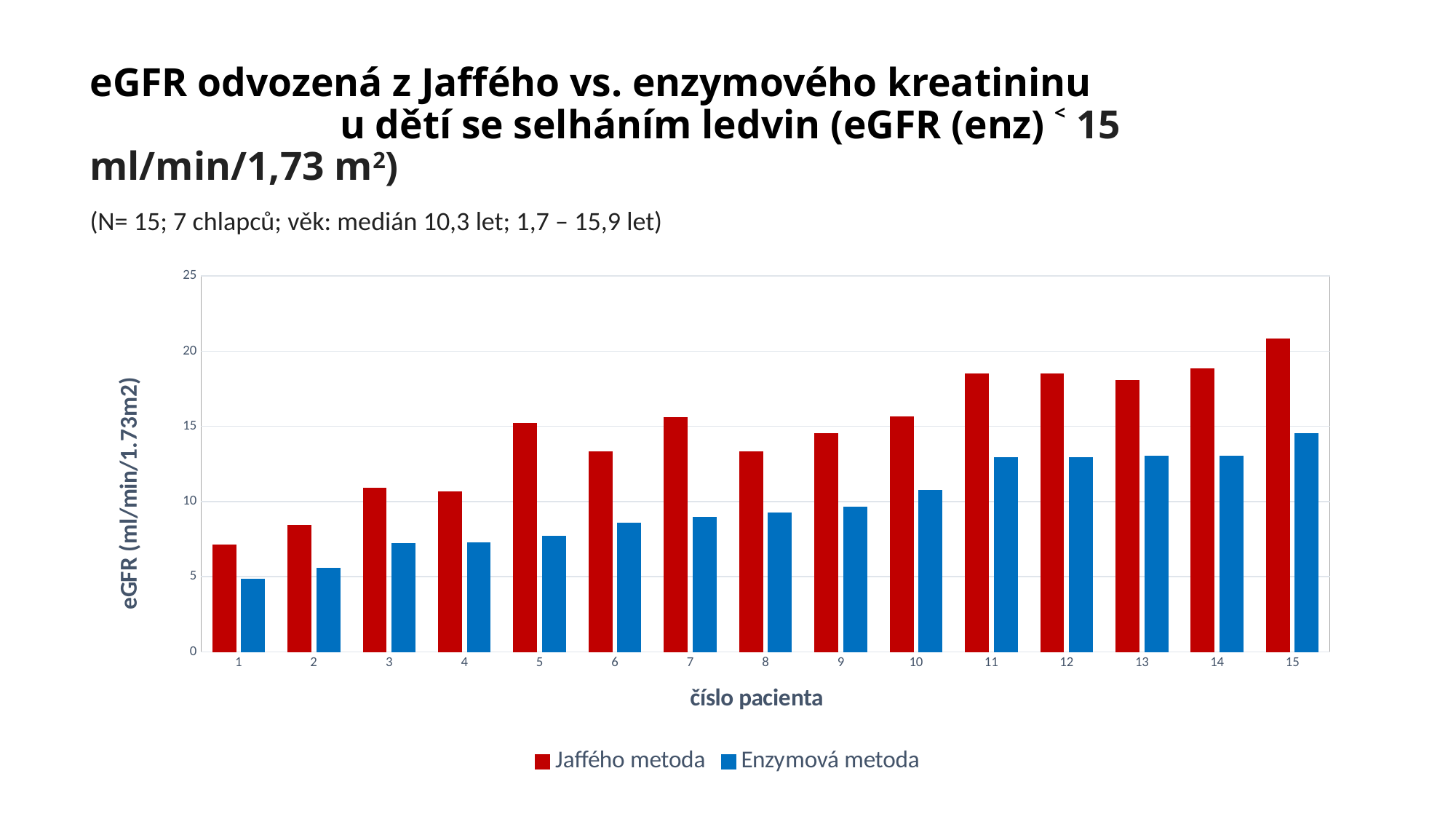
How many patients are shown on the x axis? 15 Which patient has the lowest value for Jaffého metoda? 1 Is the Jaffého metoda value for patient 15 greater or less than 20? greater Is the Enzymová metoda value for patient 6 greater or less than 10? less Which patient has the lowest value for Enzymová metoda? 1 Which patient has the highest value for Jaffého metoda? 15 Which series is shown in red? Jaffého metoda What kind of chart is shown on the slide? bar chart Do the Enzymová metoda values generally rise or fall from patient 1 to patient 15? rise How many series does the legend list? 2 Which is larger: the Jaffého metoda value for patient 5 or for patient 6? patient 5